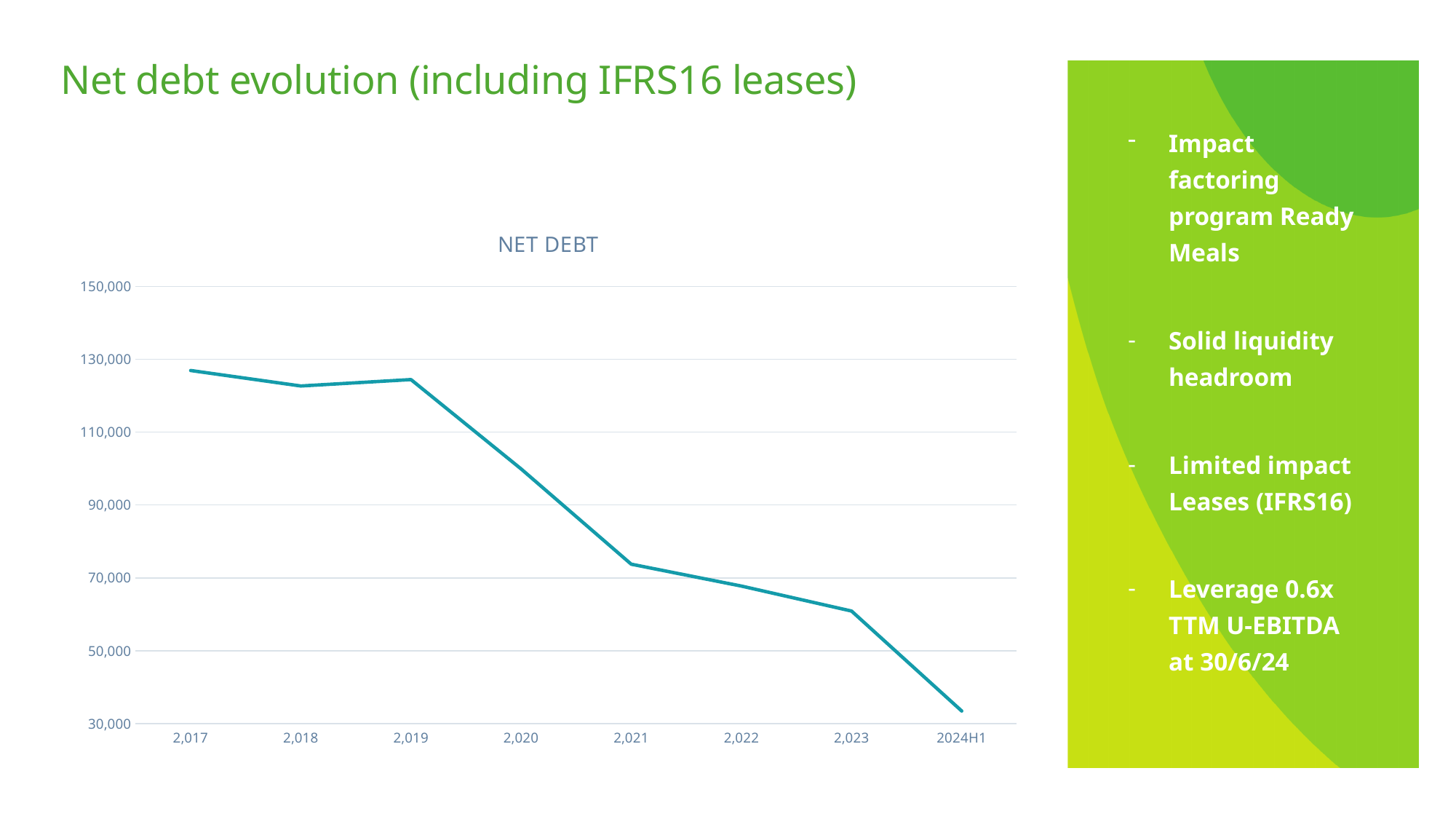
Is the value for 2024H1 greater or less than 50,000? less Which is larger, the net debt in 2,019 or in 2,022? 2,019 What kind of chart is shown on the slide? line chart Is the value for 2,017 greater or less than 110,000? greater Which period has the lowest net debt? 2024H1 Is the value for 2,023 greater or less than 70,000? less Do the net debt values generally rise or fall from 2,017 to 2024H1? fall What is the label of the last category on the x axis? 2024H1 How many data points are plotted on the line? 8 What is the title of the chart? NET DEBT